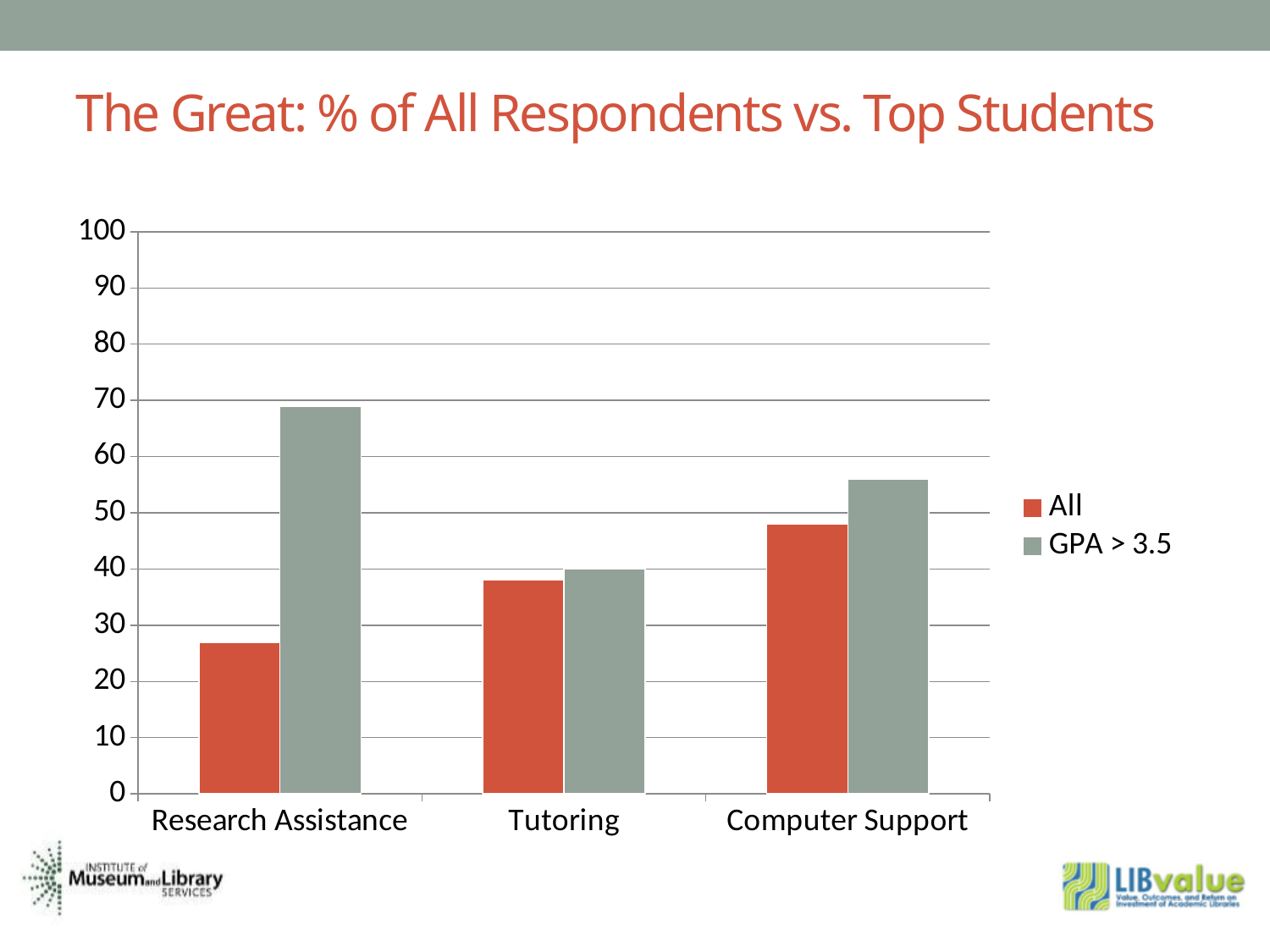
Is the All value for Research Assistance greater or less than 30? less Which category has the highest value for the All series? Computer Support Is the GPA > 3.5 value for Computer Support greater or less than 50? greater Which category has the highest value for the GPA > 3.5 series? Research Assistance For Research Assistance, which series has the larger value, All or GPA > 3.5? GPA > 3.5 What kind of chart is shown on the slide? bar chart What is the title of the chart on the slide? The Great: % of All Respondents vs. Top Students Is the GPA > 3.5 value for Research Assistance greater or less than 60? greater How many categories are shown on the x axis? 3 Which category has the lowest value for the GPA > 3.5 series? Tutoring Which category has the lowest value for the All series? Research Assistance How many series does the legend list? 2